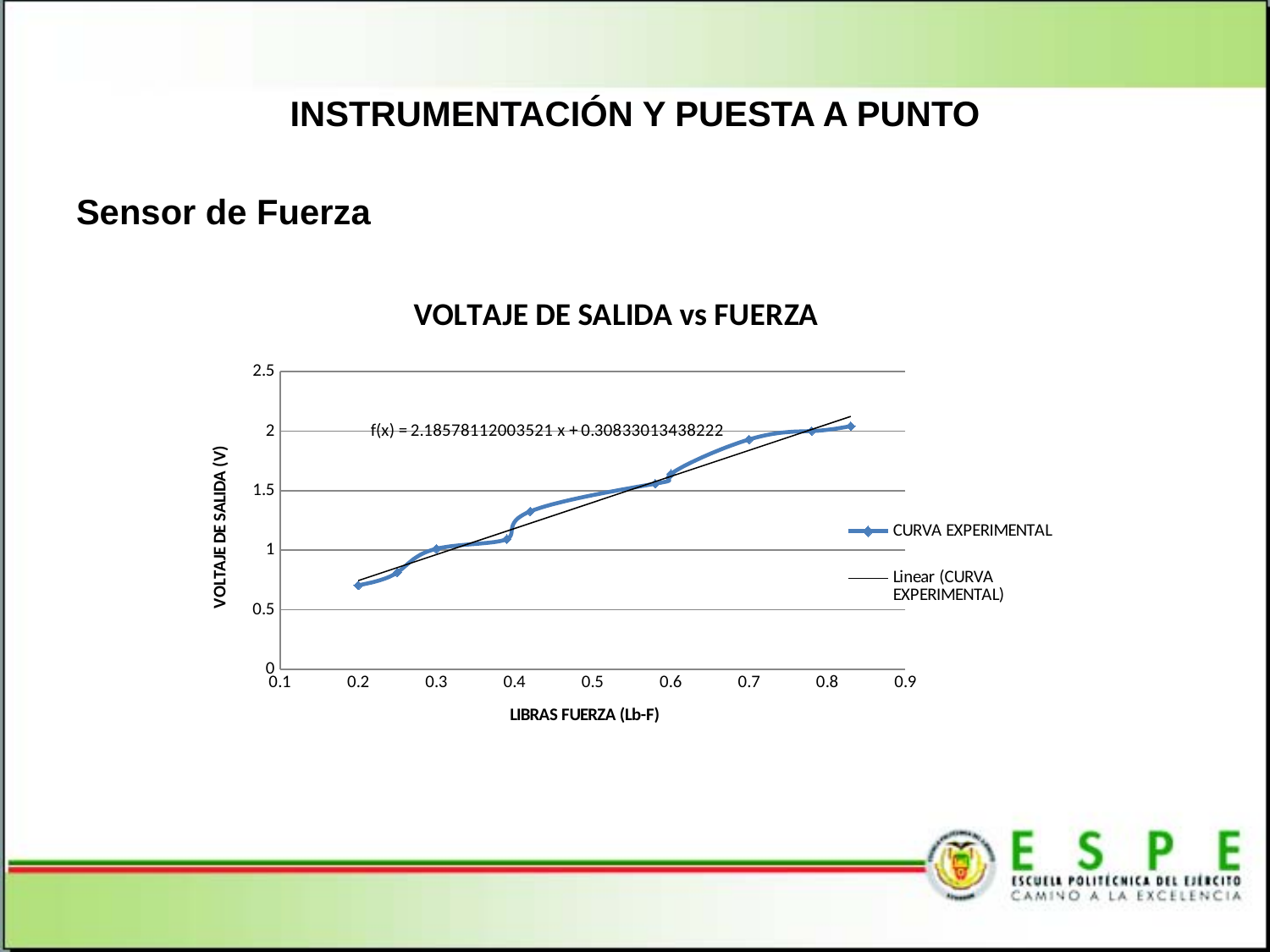
Is the CURVA EXPERIMENTAL value at 0.7 Lb-F greater or less than 1.5 V? greater Is the CURVA EXPERIMENTAL value at 0.2 Lb-F greater or less than 0.5 V? greater At which x value does the CURVA EXPERIMENTAL series reach its lowest voltage? 0.2 Do the values of CURVA EXPERIMENTAL rise or fall as force increases along the x axis? rise What is the label of the x axis? LIBRAS FUERZA (Lb-F) How many series does the chart legend list? 2 What kind of chart is shown on the slide? line chart Is the CURVA EXPERIMENTAL value at 0.2 Lb-F greater or less than 1 V? less What is the title of the chart? VOLTAJE DE SALIDA vs FUERZA Which has the higher output voltage on the CURVA EXPERIMENTAL series: 0.2 Lb-F or 0.7 Lb-F? 0.7 Lb-F What is the slope shown in the trendline equation f(x) on the chart? 2.18578112003521